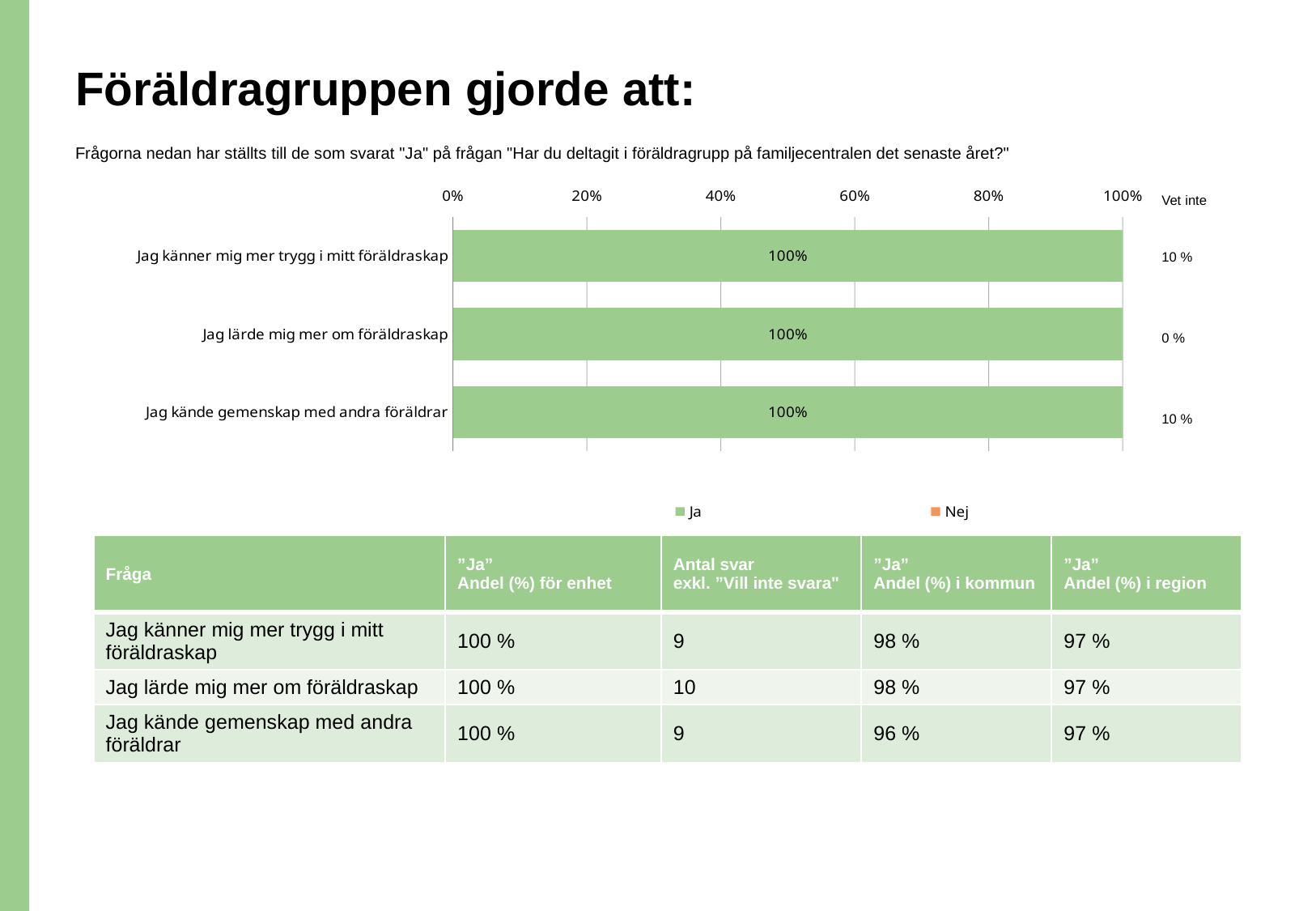
Is the "Ja" value for "Jag kände gemenskap med andra föräldrar" greater or less than 60%? greater What is the "Ja" value for "Jag lärde mig mer om föräldraskap"? 100% What colour represents the "Ja" series in the chart? green What is the total of the stacked bar for "Jag känner mig mer trygg i mitt föräldraskap"? 100% What is the "Ja" value for "Jag kände gemenskap med andra föräldrar"? 100% What is the "Ja" value for "Jag känner mig mer trygg i mitt föräldraskap"? 100% Is the "Ja" value for "Jag lärde mig mer om föräldraskap" greater or less than 80%? greater What are the two series named in the chart legend? Ja and Nej How many categories (statements) are shown in the chart? 3 What kind of chart is shown on the slide? bar chart How many series does the legend list? 2 What is the difference between the "Ja" values for "Jag känner mig mer trygg i mitt föräldraskap" and "Jag lärde mig mer om föräldraskap"? 0%